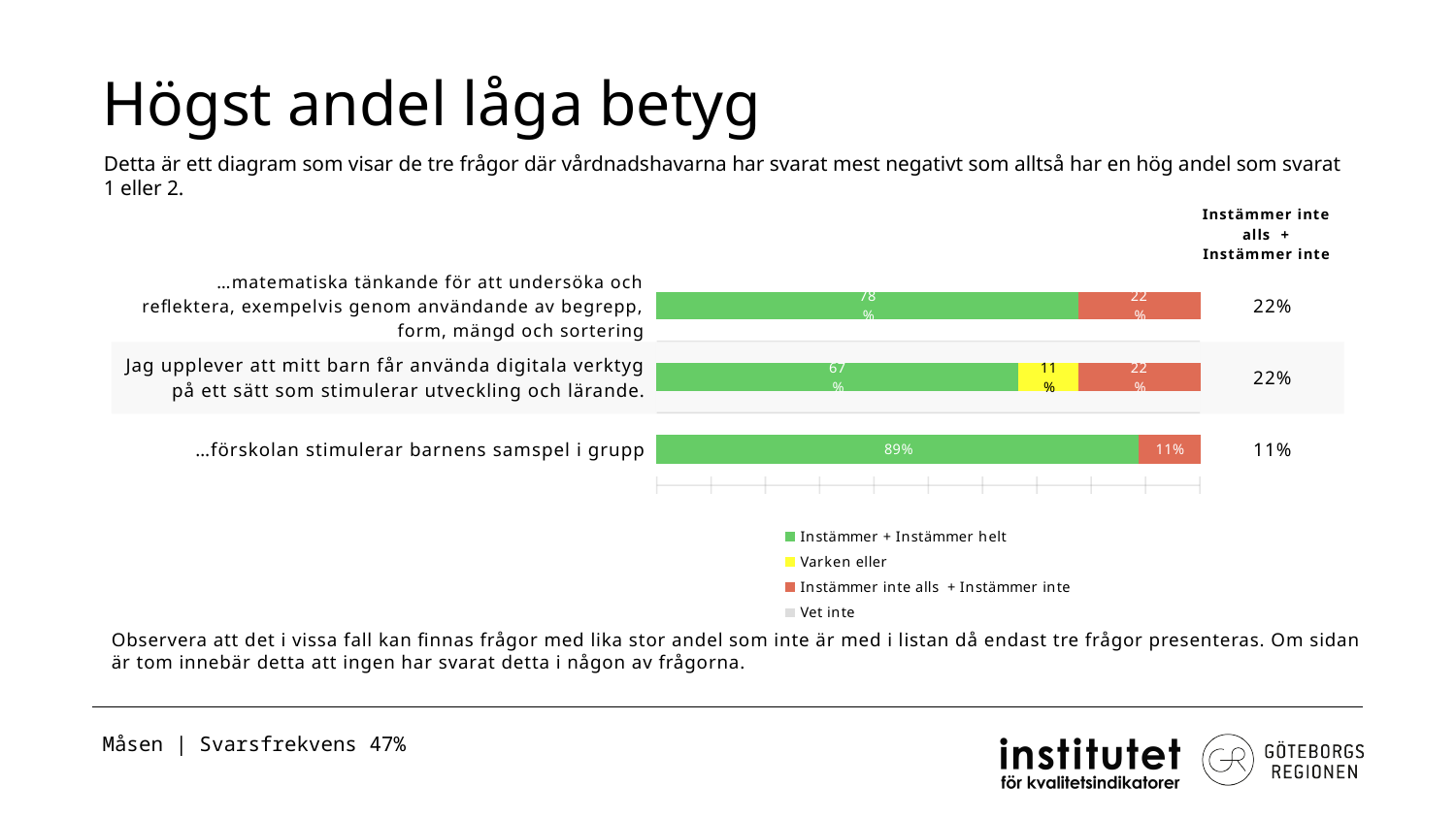
What is the value of "Instämmer inte alls + Instämmer inte" for "…matematiska tänkande för att undersöka och reflektera, exempelvis genom användande av begrepp, form, mängd och sortering"? 22% What is the value of "Instämmer + Instämmer helt" for "…förskolan stimulerar barnens samspel i grupp"? 89% What is the value of "Varken eller" for "Jag upplever att mitt barn får använda digitala verktyg på ett sätt som stimulerar utveckling och lärande."? 11% What is the difference between the "Instämmer + Instämmer helt" values for "…förskolan stimulerar barnens samspel i grupp" and "…matematiska tänkande för att undersöka och reflektera, exempelvis genom användande av begrepp, form, mängd och sortering"? 11% Which category has the highest value for "Instämmer + Instämmer helt"? …förskolan stimulerar barnens samspel i grupp What kind of chart is shown on the slide? stacked bar chart How many categories (questions) are plotted in the chart? 3 Which is larger: the "Instämmer inte alls + Instämmer inte" value for "…förskolan stimulerar barnens samspel i grupp" or for "Jag upplever att mitt barn får använda digitala verktyg på ett sätt som stimulerar utveckling och lärande."? Jag upplever att mitt barn får använda digitala verktyg på ett sätt som stimulerar utveckling och lärande. What is the value of "Instämmer + Instämmer helt" for "Jag upplever att mitt barn får använda digitala verktyg på ett sätt som stimulerar utveckling och lärande."? 67% Which category has the lowest value for "Instämmer + Instämmer helt"? Jag upplever att mitt barn får använda digitala verktyg på ett sätt som stimulerar utveckling och lärande. What is the title of the slide containing the chart? Högst andel låga betyg How many series does the legend list? 4